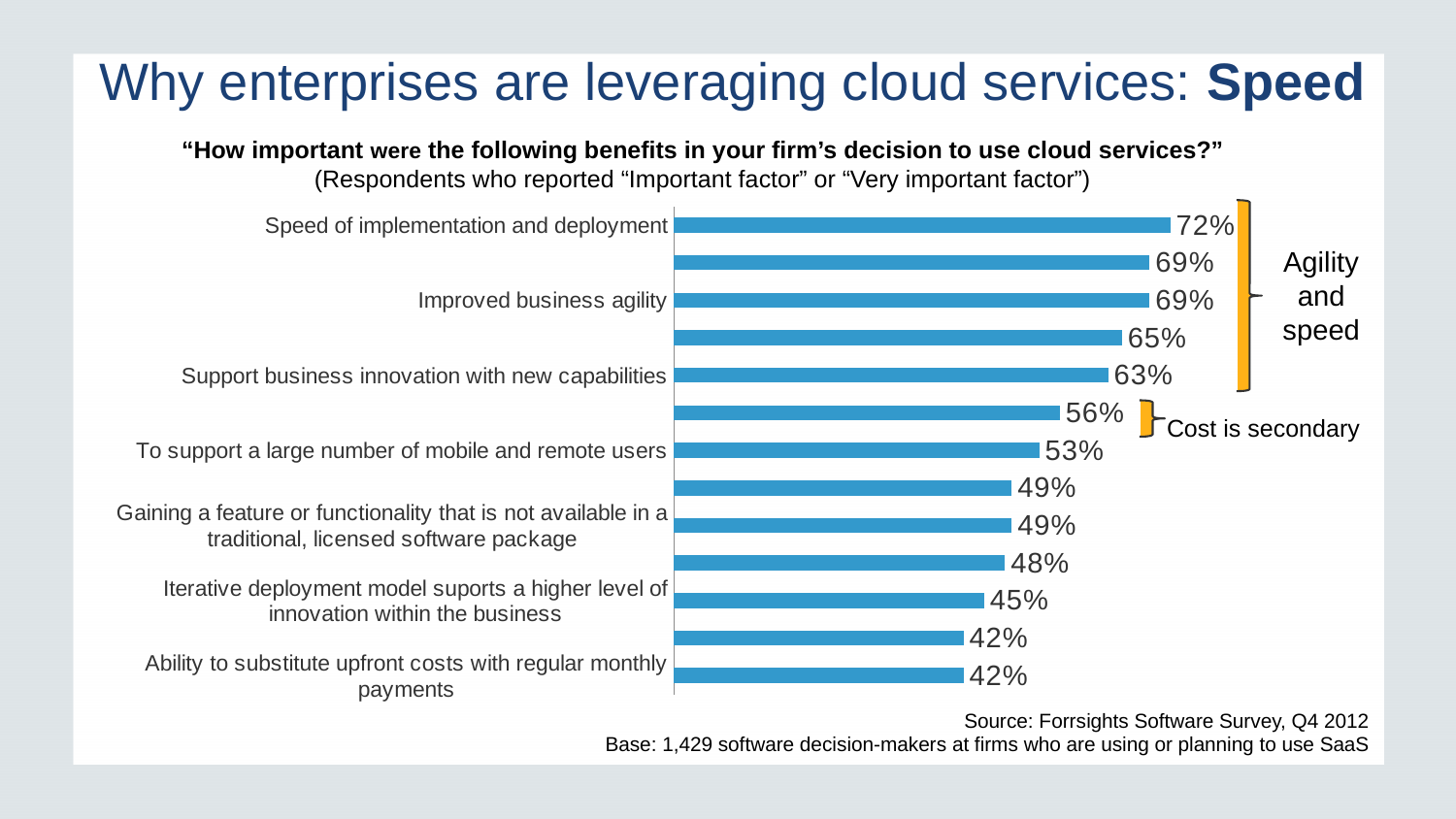
How many bars are plotted in the chart? 13 What is the value shown for "Support business innovation with new capabilities"? 63% What is the value shown for "Iterative deployment model suports a higher level of innovation within the business"? 45% What is the value shown for "Ability to substitute upfront costs with regular monthly payments"? 42% What type of chart is shown on the slide? Bar chart Which benefit has the highest percentage in the chart? Speed of implementation and deployment Which has a higher value: "Improved business agility" or "Support business innovation with new capabilities"? Improved business agility What percentage of respondents rated "Speed of implementation and deployment" as an important or very important factor? 72% What is the value shown for "To support a large number of mobile and remote users"? 53% What is the value shown for "Gaining a feature or functionality that is not available in a traditional, licensed software package"? 49% What is the value shown for "Improved business agility"? 69% What is the difference in percentage points between "Speed of implementation and deployment" and "Ability to substitute upfront costs with regular monthly payments"? 30 percentage points